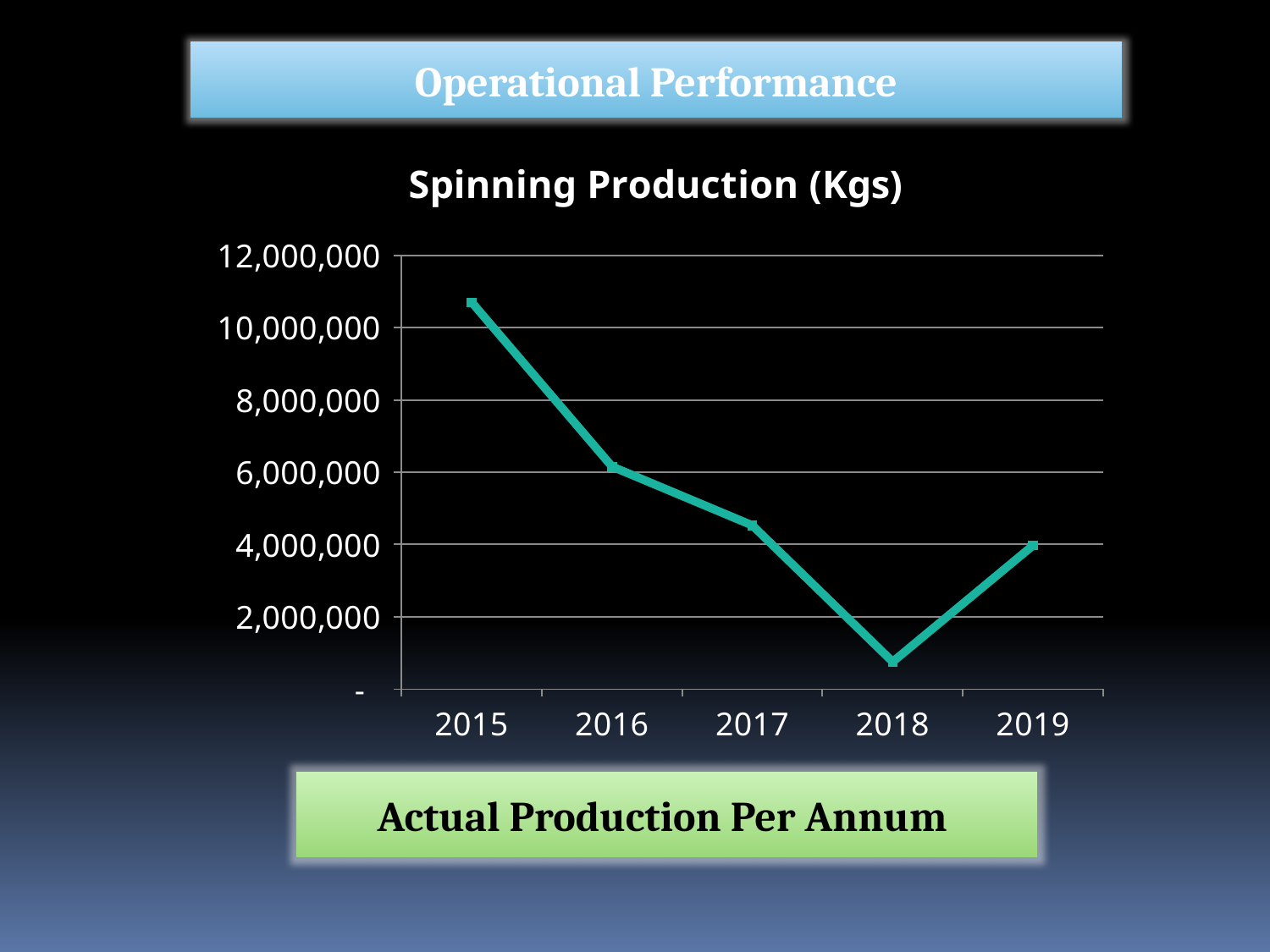
Which year has the larger spinning production, 2018 or 2019? 2019 Which year has the lowest spinning production? 2018 How many years are plotted on the x axis? 5 Is the value for 2018 greater or less than 2,000,000? less Is the value for 2015 greater or less than 10,000,000? greater Is the value for 2016 greater or less than 8,000,000? less Does spinning production rise or fall from 2015 to 2018? fall Which year has the larger spinning production, 2016 or 2017? 2016 Which year has the highest spinning production? 2015 What kind of chart is shown on the slide? line chart What is the title of the chart? Spinning Production (Kgs)